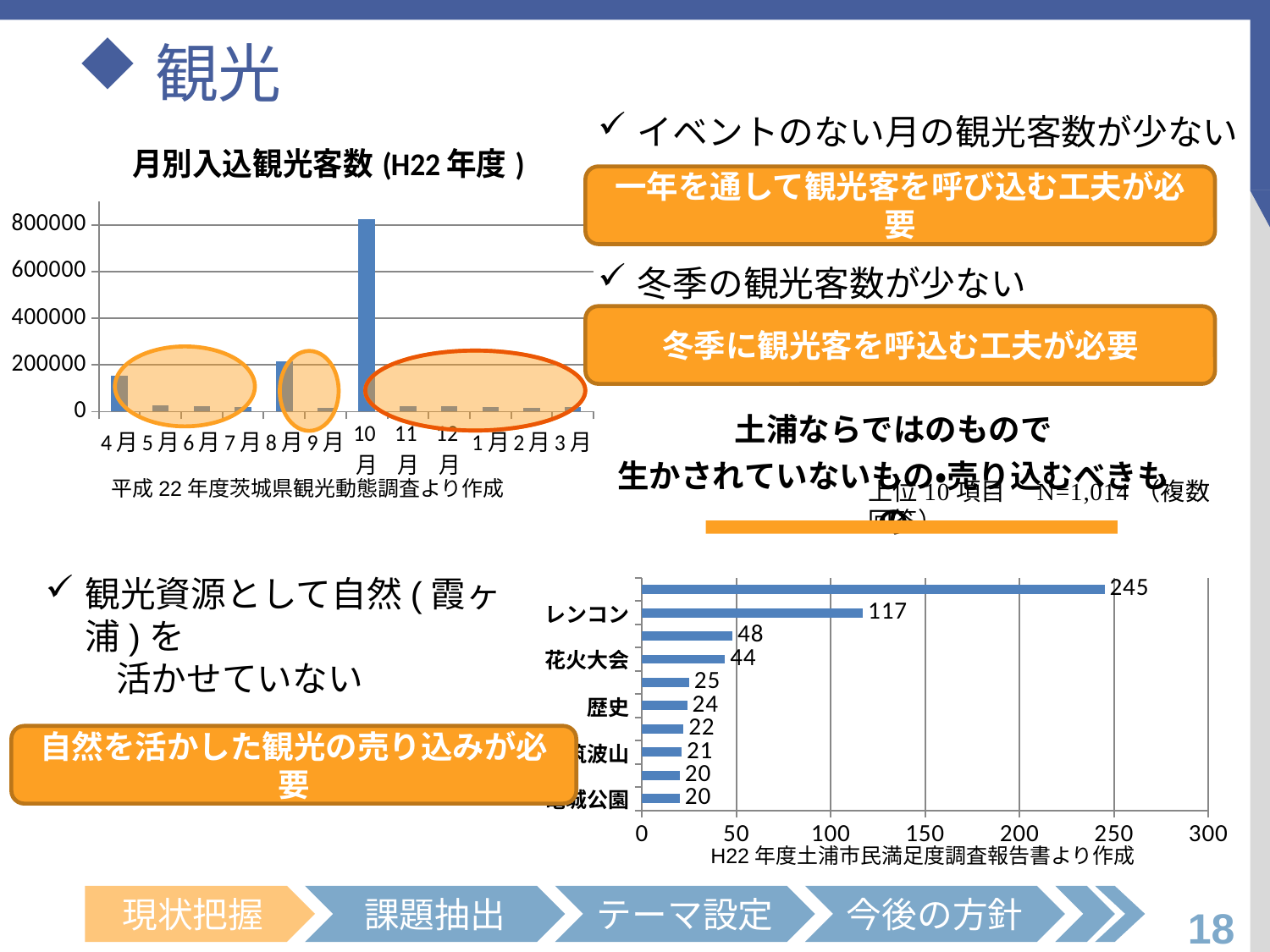
In the 月別入込観光客数 (H22年度) chart, is the value for 4月 greater or less than 200000? less In the horizontal bar chart at the bottom right of the slide, which is larger, the value for レンコン or the value for 歴史? レンコン What kind of chart is the 月別入込観光客数 (H22年度) chart at the top left of the slide? bar chart In the horizontal bar chart at the bottom right of the slide, what is the largest value shown? 245 In the horizontal bar chart at the bottom right of the slide, what is the difference between the value for レンコン and the value for 花火大会? 73 In the 月別入込観光客数 (H22年度) chart, which month has the highest number of visitors? 10月 In the horizontal bar chart at the bottom right of the slide, what is the value for 花火大会? 44 In the horizontal bar chart at the bottom right of the slide, what is the value for 歴史? 24 In the 月別入込観光客数 (H22年度) chart, is the value for 10月 greater or less than 600000? greater How many months are shown on the x axis of the 月別入込観光客数 (H22年度) chart? 12 In the horizontal bar chart at the bottom right of the slide, what is the value for レンコン? 117 In the horizontal bar chart at the bottom right of the slide, how many bars are plotted? 10